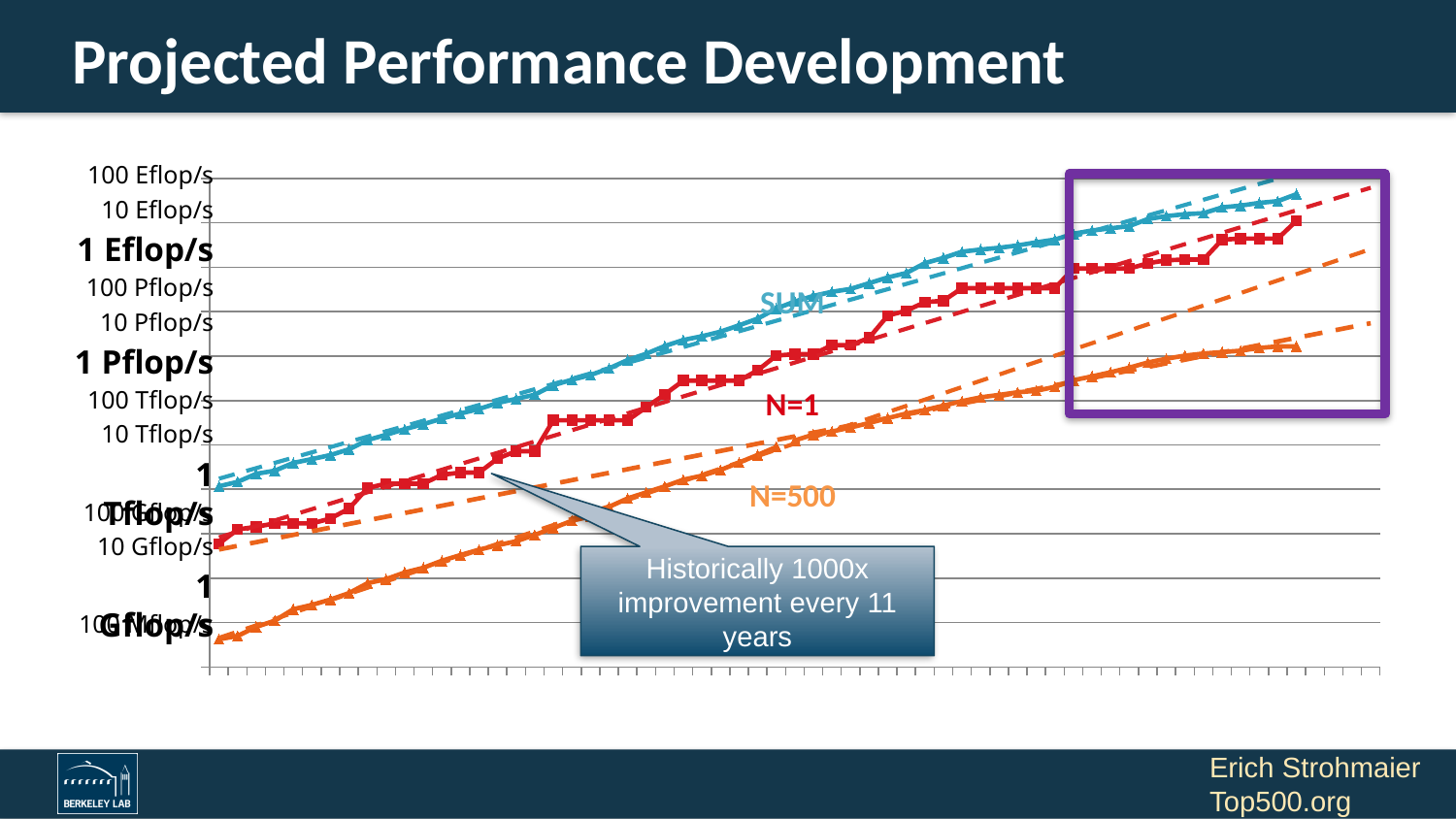
Is the final value of the N=500 series greater or less than 1 Pflop/s? greater Which series is higher, N=1 or N=500? N=1 What kind of chart is shown on the slide? line chart What does the callout box on the chart say about historical improvement? Historically 1000x improvement every 11 years Is the final value of the SUM series greater or less than 1 Eflop/s? greater What is the title of the chart on the slide? Projected Performance Development Which series is higher, SUM or N=1? SUM Is the final value of the N=1 series greater or less than 100 Pflop/s? greater Which series has the lowest values across the chart? N=500 Which series has the highest values across the chart? SUM Do the values of the SUM series rise or fall along the x axis? rise How many data series are labelled on the chart? 3